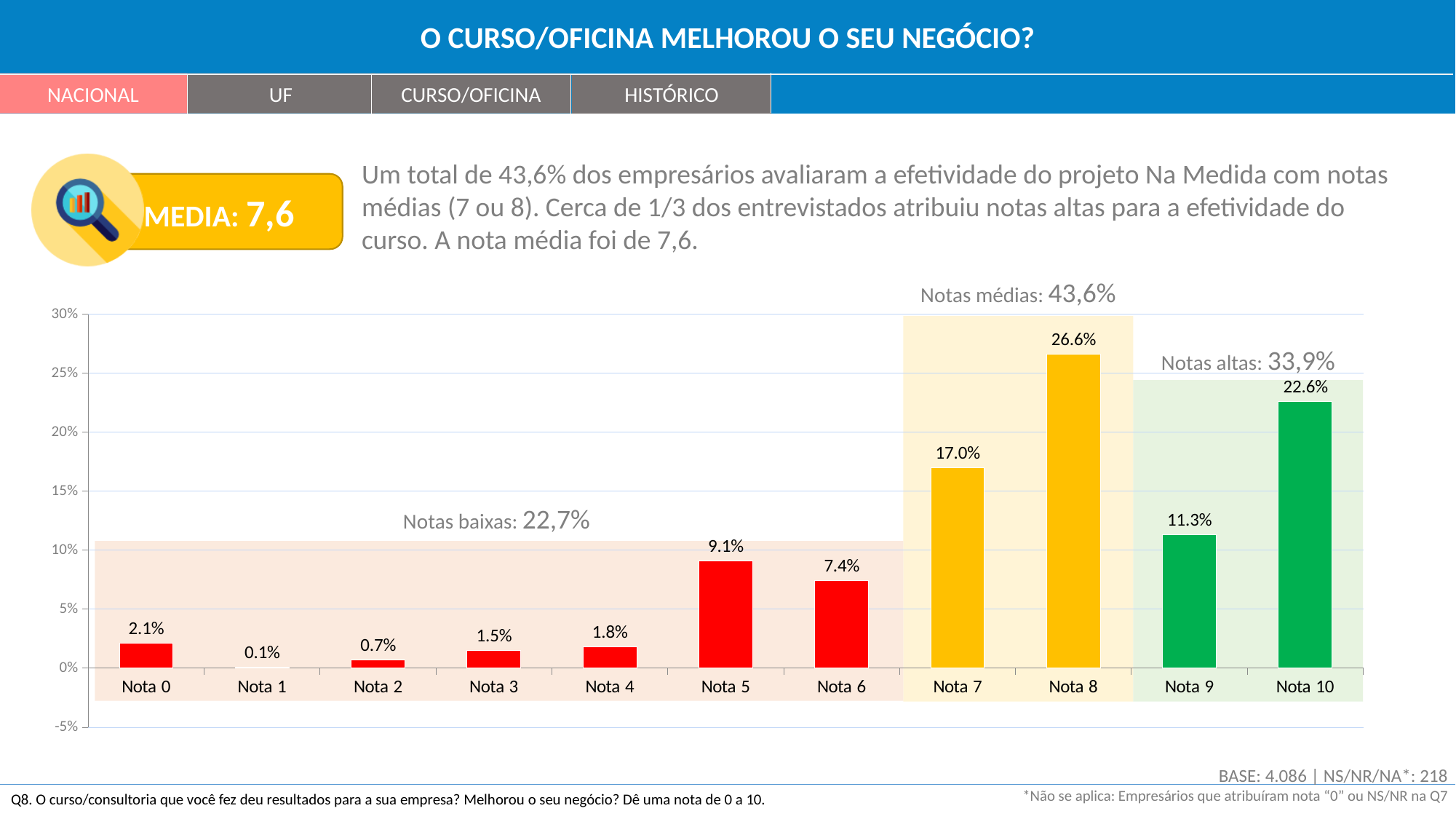
What is the total share labelled for 'Notas médias' on the chart? 43,6% What colour are the bars for Nota 9 and Nota 10? green Which category has the lowest value? Nota 1 Which is larger, the value for Nota 5 or the value for Nota 6? Nota 5 What kind of chart is shown on the slide? bar chart Which category has the highest value? Nota 8 What is the value for Nota 8? 26.6% What is the value for Nota 1? 0.1% How many categories are shown on the x axis? 11 What is the value for Nota 9? 11.3% What is the difference between the values for Nota 8 and Nota 10? 4.0% Is the value for Nota 7 greater or less than 15%? greater